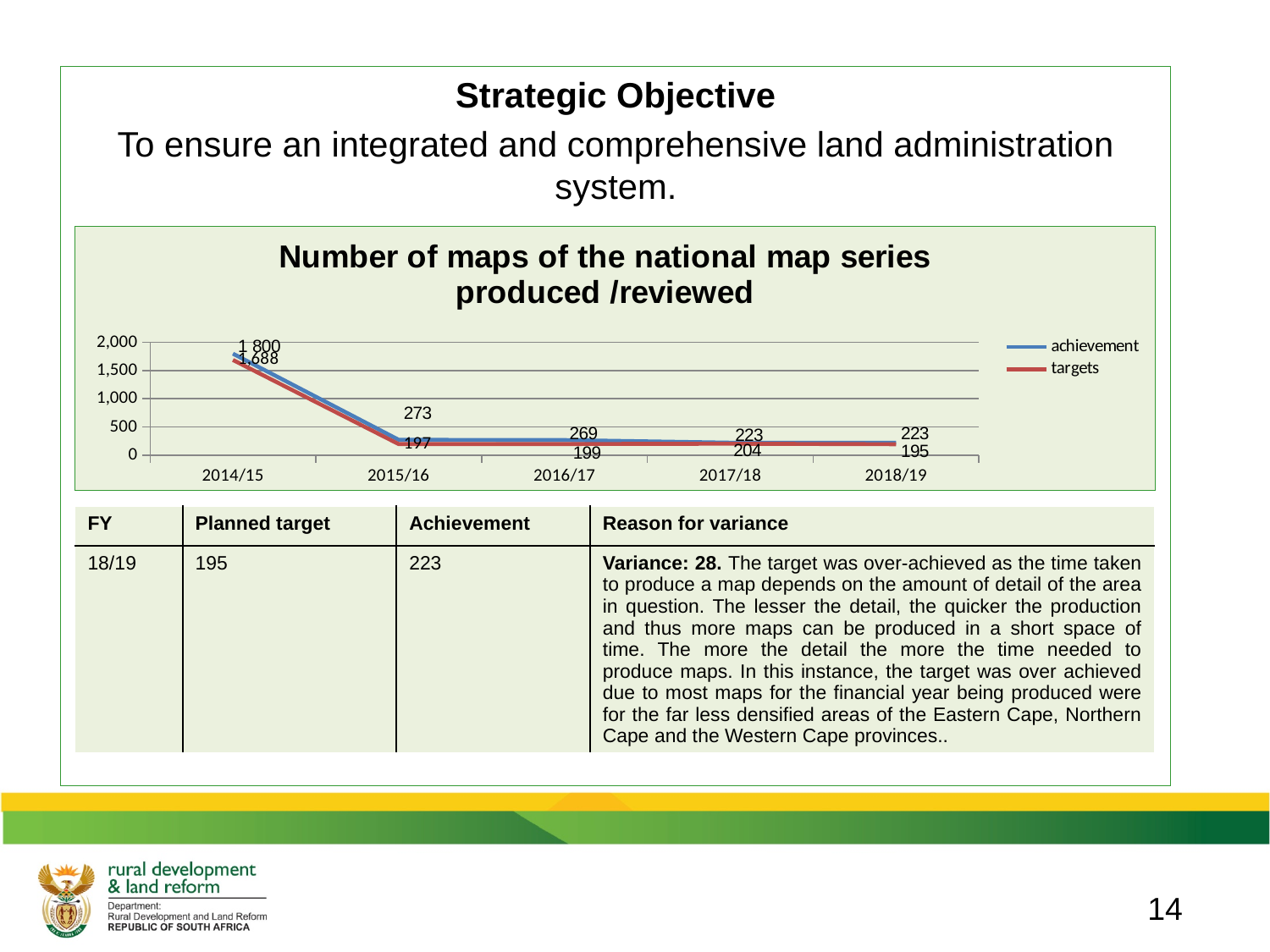
What is the targets value for 2018/19? 195 How many series does the chart legend list? 2 What is the difference between the achievement and targets values for 2018/19? 28 What is the title of the chart? Number of maps of the national map series produced /reviewed What is the targets value for 2017/18? 204 What is the achievement value for 2015/16? 273 Does the achievement series rise or fall from 2014/15 to 2015/16? fall How many financial years are plotted on the x axis of the chart? 5 What type of chart is shown on the slide? line chart Which is larger in 2016/17, the achievement value or the targets value? achievement In which financial year is the targets value lowest? 2018/19 In which financial year is the achievement value highest? 2014/15